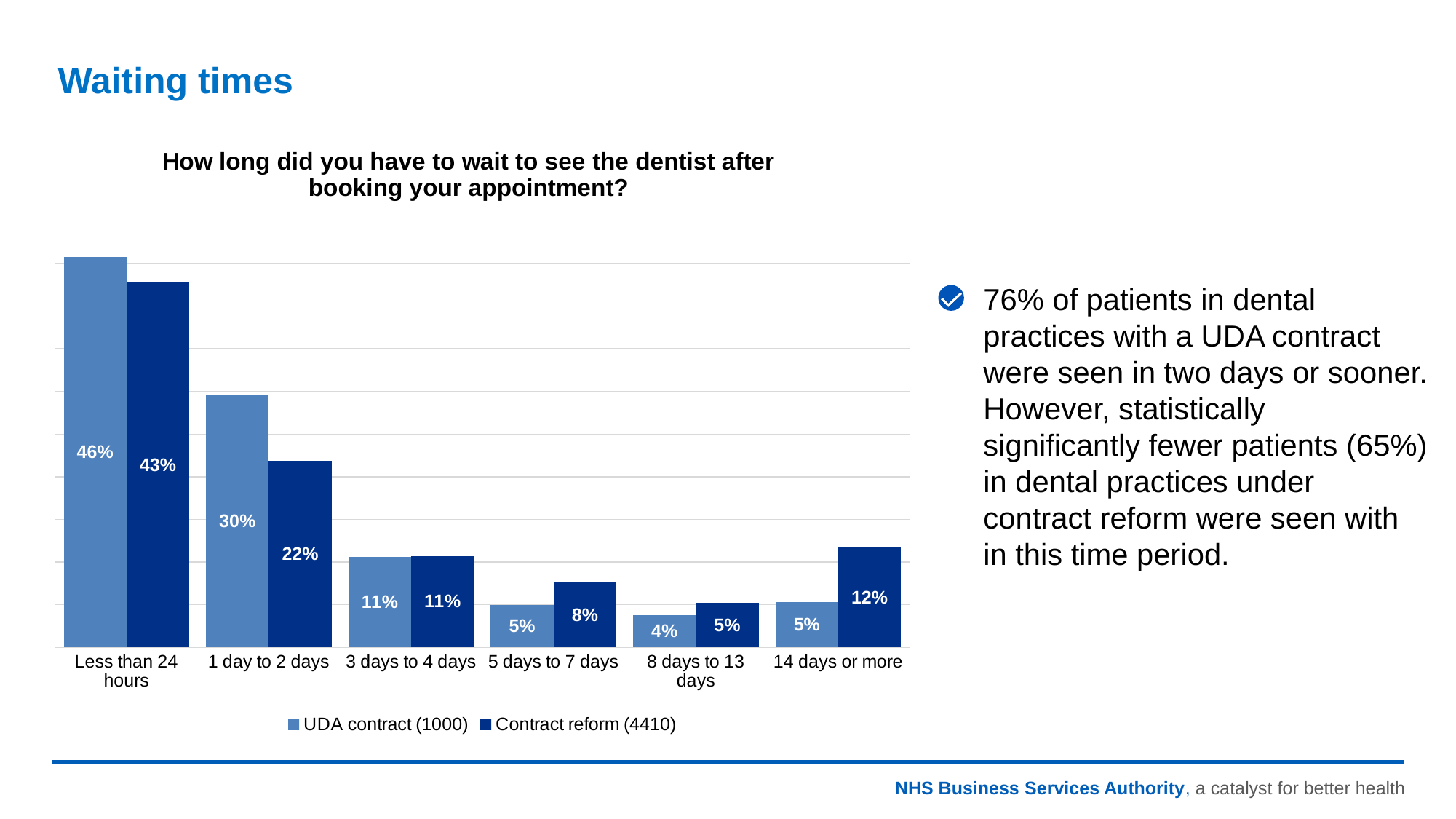
What percentage of Contract reform patients waited 1 day to 2 days? 22% What kind of chart is shown on the slide? Bar chart What is the difference between the UDA contract and Contract reform values for 1 day to 2 days? 8 percentage points What percentage of Contract reform patients waited 14 days or more? 12% Which waiting time category has the highest value for the UDA contract series? Less than 24 hours What percentage of UDA contract patients waited less than 24 hours to see the dentist? 46% How many series does the legend list? 2 What is the sample size shown in the legend for the Contract reform series? 4410 Which waiting time category has the lowest value for the UDA contract series? 8 days to 13 days For 14 days or more, which series has the larger value: UDA contract or Contract reform? Contract reform How many waiting time categories are shown on the x axis? 6 What is the title of the chart? How long did you have to wait to see the dentist after booking your appointment?